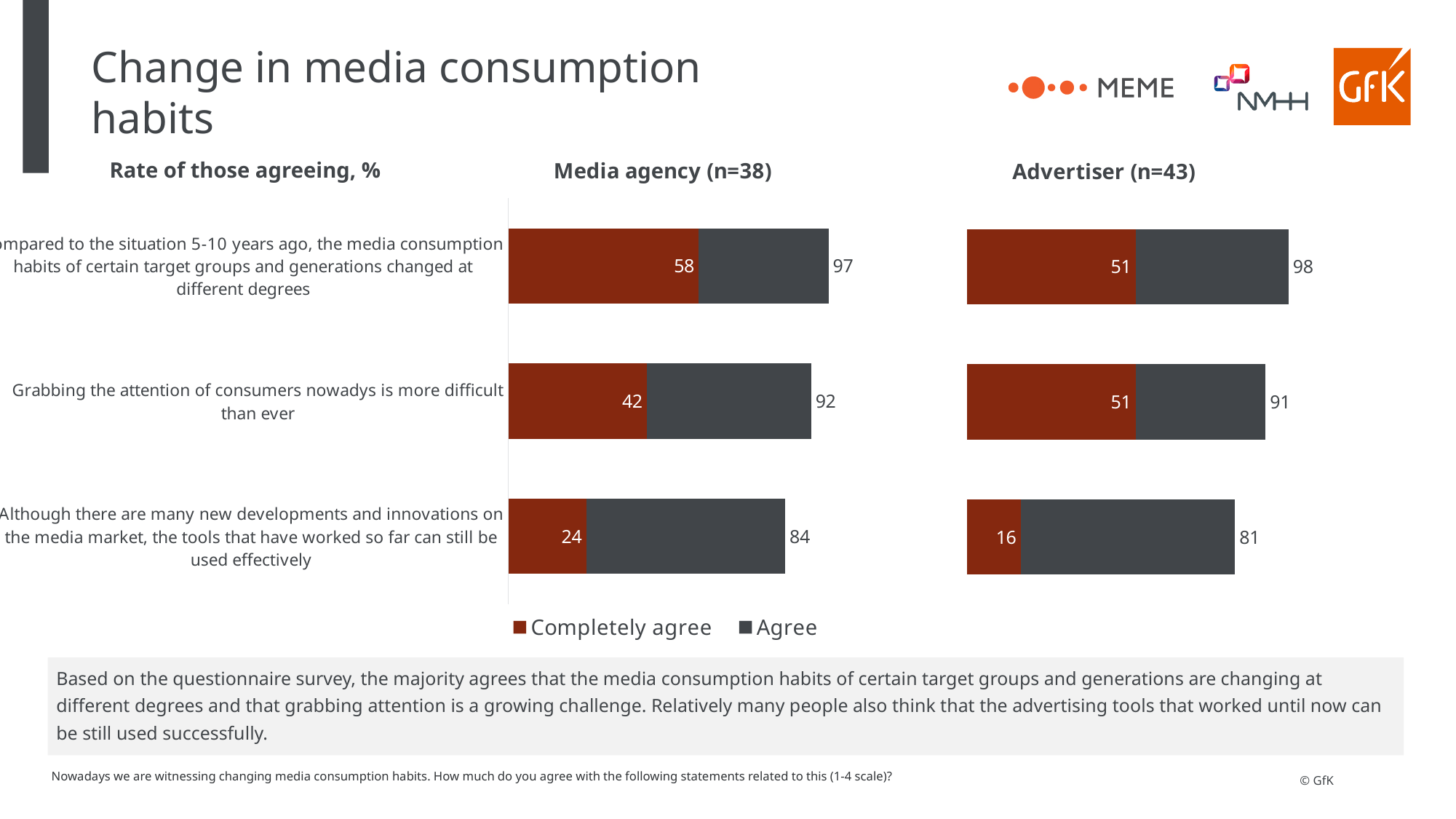
Which colour represents 'Completely agree' in the legend? Dark red In the Advertiser (n=43) chart, what is the total rate of those agreeing that grabbing the attention of consumers nowadays is more difficult than ever? 91 In the Advertiser (n=43) chart, which statement has the lowest 'Completely agree' value? Although there are many new developments and innovations on the media market, the tools that have worked so far can still be used effectively Which is larger: the Media agency total agreeing (97) or the Advertiser total agreeing (98) for the statement about media consumption habits changing at different degrees? Advertiser (98) What is the difference between the Media agency and Advertiser 'Completely agree' values for the statement that grabbing the attention of consumers nowadays is more difficult than ever? 9 What type of chart is used for the Advertiser (n=43) data? Stacked bar chart How many series does the legend list for the charts? 2 In the Advertiser (n=43) chart, what percentage completely agree that the tools that have worked so far can still be used effectively? 16 In the Media agency (n=38) chart, what is the total rate of those agreeing that the tools that have worked so far can still be used effectively? 84 How many statements are shown in the Media agency (n=38) chart? 3 In the Media agency (n=38) chart, what percentage completely agree that grabbing the attention of consumers nowadays is more difficult than ever? 42 In the Media agency (n=38) chart, which statement has the highest total rate of those agreeing? Compared to the situation 5-10 years ago, the media consumption habits of certain target groups and generations changed at different degrees